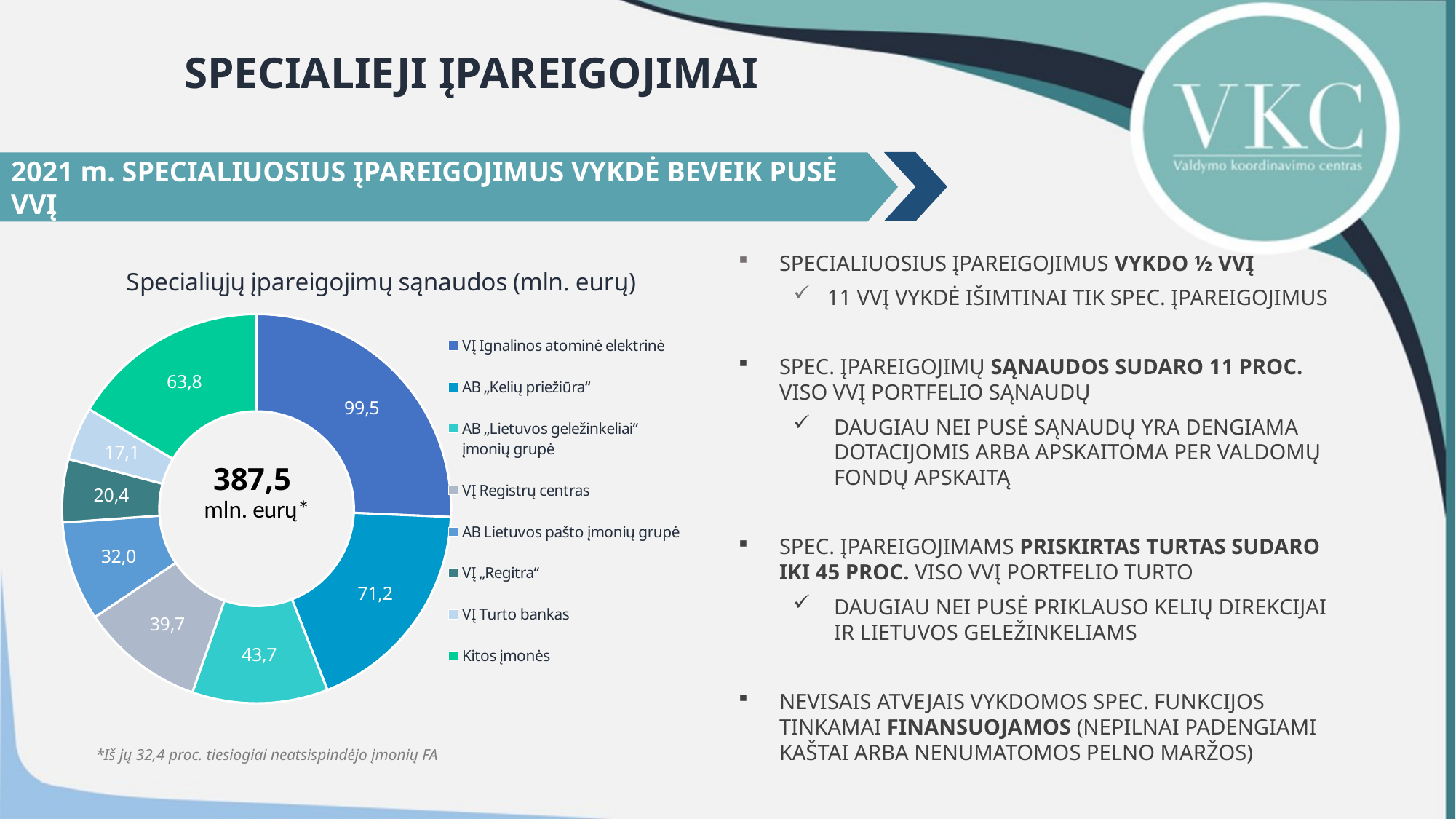
What is the value for VĮ Ignalinos atominė elektrinė in the chart? 99,5 What total value is shown in the centre of the chart? 387,5 mln. eurų What kind of chart is shown on the slide? Doughnut (pie) chart What is the value for AB „Kelių priežiūra“ in the chart? 71,2 What is the difference between the values for VĮ Ignalinos atominė elektrinė and AB „Kelių priežiūra“? 28,3 Which category has the smallest value in the chart? VĮ Turto bankas What is the title of the chart? Specialiųjų įpareigojimų sąnaudos (mln. eurų) Which category has the largest value in the chart? VĮ Ignalinos atominė elektrinė What is the value for Kitos įmonės in the chart? 63,8 How many categories are shown in the chart? 8 Which is larger: the value for VĮ Registrų centras or the value for AB Lietuvos pašto įmonių grupė? VĮ Registrų centras What is the value for VĮ „Regitra“ in the chart? 20,4